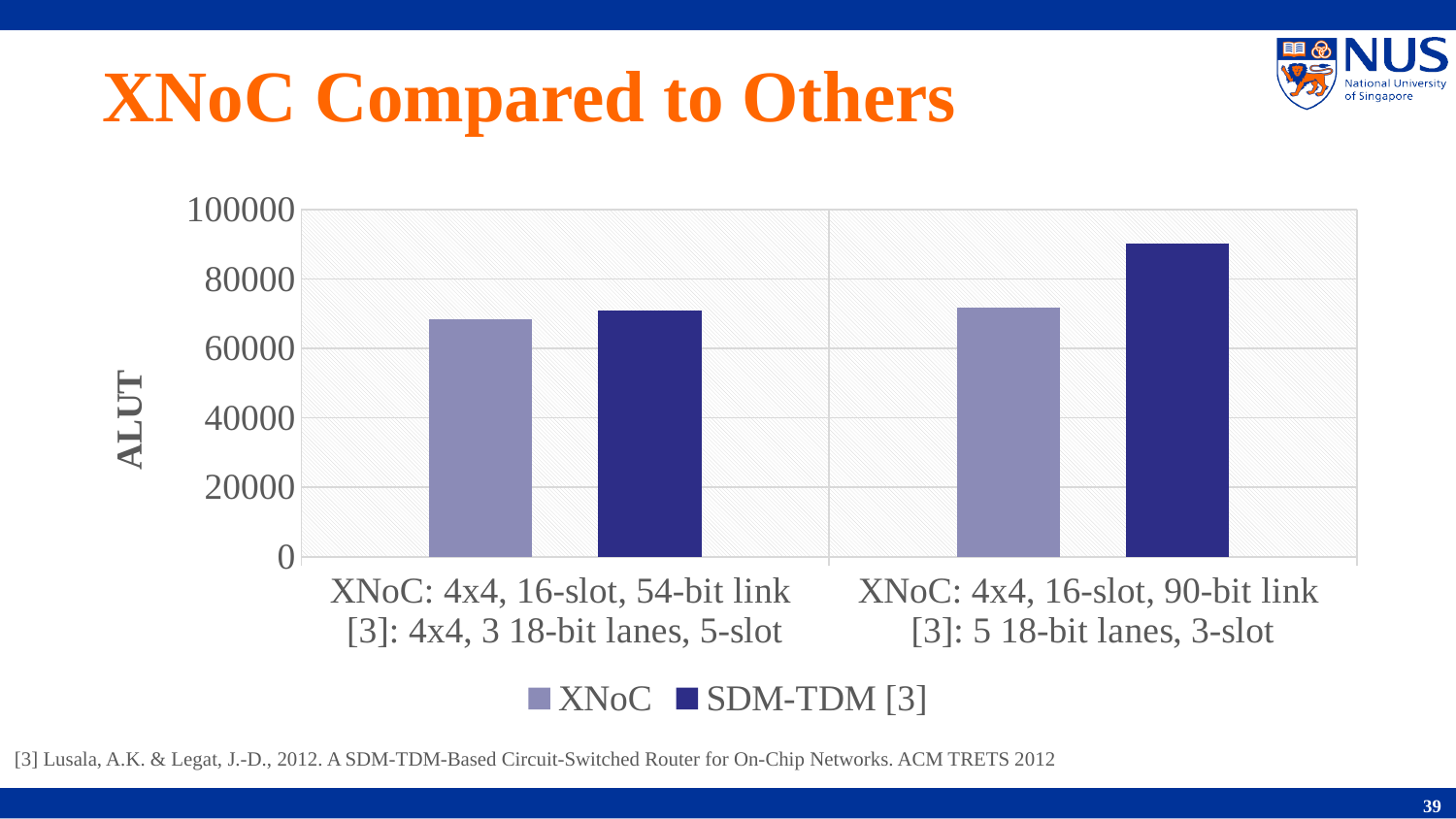
How many series does the legend list? 2 How many category groups are shown on the x axis? 2 Does the SDM-TDM [3] value rise or fall from the first group to the second group? rise Is the SDM-TDM [3] value for the 3 18-bit lanes, 5-slot configuration greater or less than 80000? less Is the XNoC value for the 54-bit link configuration greater or less than 80000? less Is the XNoC value for the 54-bit link configuration greater or less than 60000? greater Which bar is the highest in the chart? SDM-TDM [3] in the 90-bit link / 5 18-bit lanes, 3-slot group What are the two series named in the legend? XNoC and SDM-TDM [3] What kind of chart is shown on the slide? bar chart In the second group (XNoC: 4x4, 16-slot, 90-bit link / [3]: 5 18-bit lanes, 3-slot), which is larger, XNoC or SDM-TDM [3]? SDM-TDM [3] What is the label of the y axis? ALUT